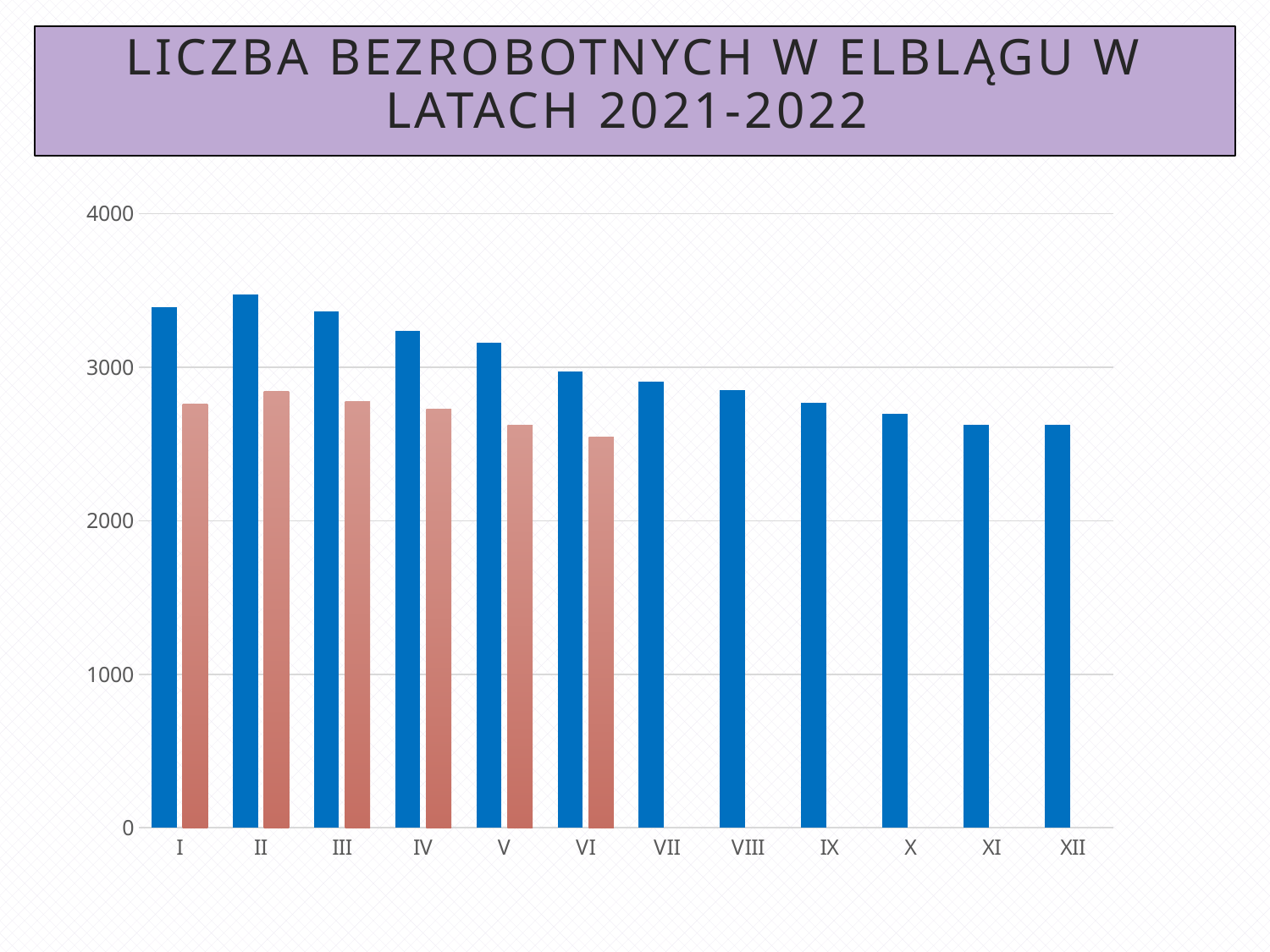
Is the value of the blue bar for month XII greater or less than 2000? greater What kind of chart is shown on the slide? Bar chart Which month has the highest blue bar? II For how many months does the chart show a red bar? 6 Is the value of the blue bar for month VII greater or less than 3000? less How many categories (months) are shown on the x axis? 12 What is the title of the chart on the slide? LICZBA BEZROBOTNYCH W ELBLĄGU W LATACH 2021-2022 Is the value of the blue bar for month II greater or less than 3000? greater Do the blue bars generally rise or fall from month I to month XII? Fall Which month has the lowest red bar? VI For month I, which bar is larger, the blue one or the red one? The blue one